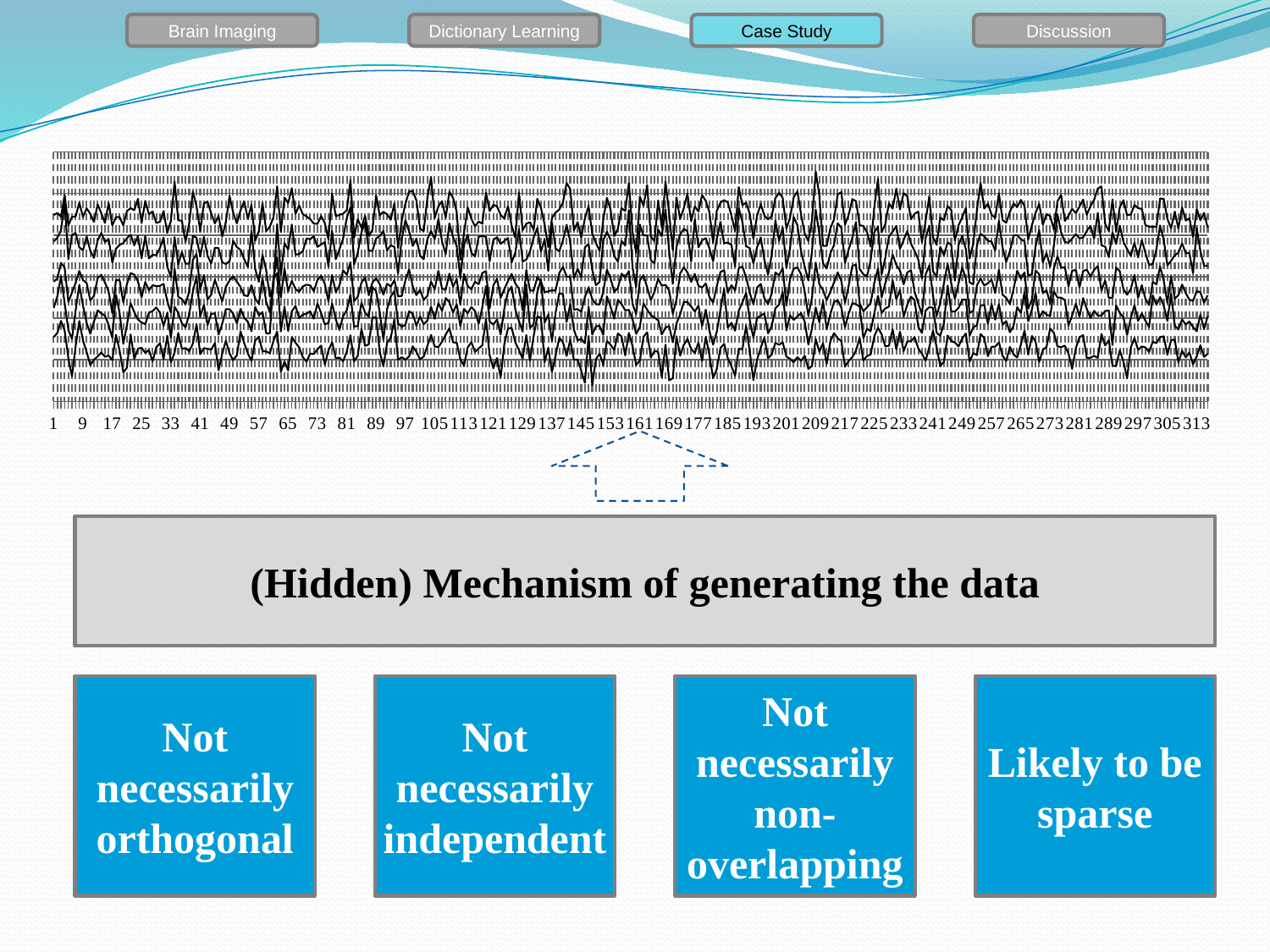
What kind of chart is shown at the top of the slide? line chart Does the chart include a legend? No What is the first label on the x axis of the chart? 1 What is the last label on the x axis of the chart? 313 How many tick labels are printed along the x axis of the chart? 40 By how much do consecutive x-axis tick labels on the chart increase? 8